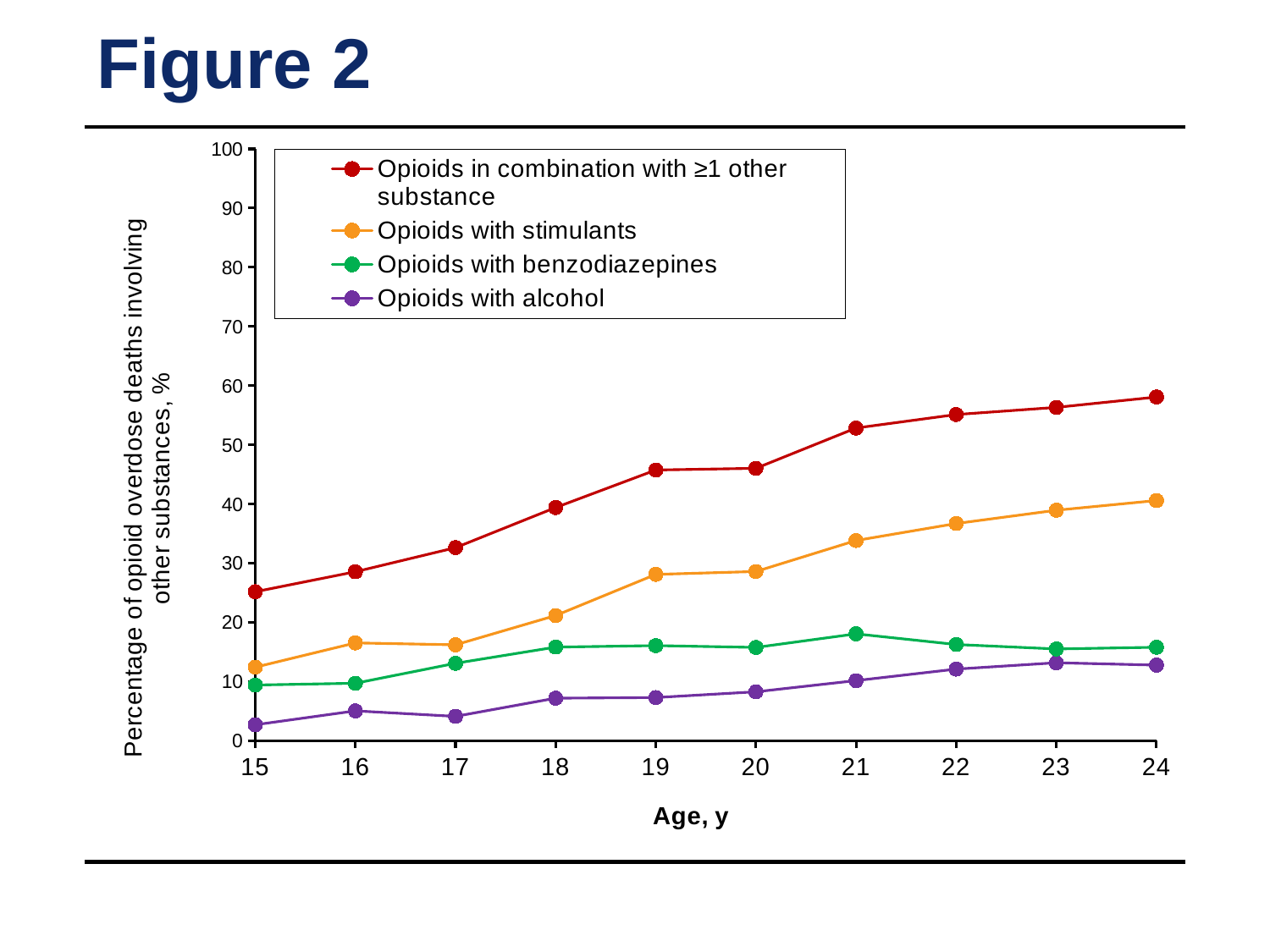
Is the value for "Opioids with stimulants" at age 15 greater or less than 20? less At age 24, which is larger: "Opioids with stimulants" or "Opioids with benzodiazepines"? Opioids with stimulants Is the value for "Opioids with benzodiazepines" at age 21 greater or less than 10? greater What kind of chart is shown on the slide? line chart Which series has the highest value at age 20? Opioids in combination with ≥1 other substance Is the value for "Opioids in combination with ≥1 other substance" at age 24 greater or less than 50? greater What is the title of the x axis? Age, y Which series has the lowest value at age 17? Opioids with alcohol How many series does the legend list? 4 How many age points are plotted along the x axis? 10 Does the value for "Opioids in combination with ≥1 other substance" rise or fall from age 15 to age 24? rise